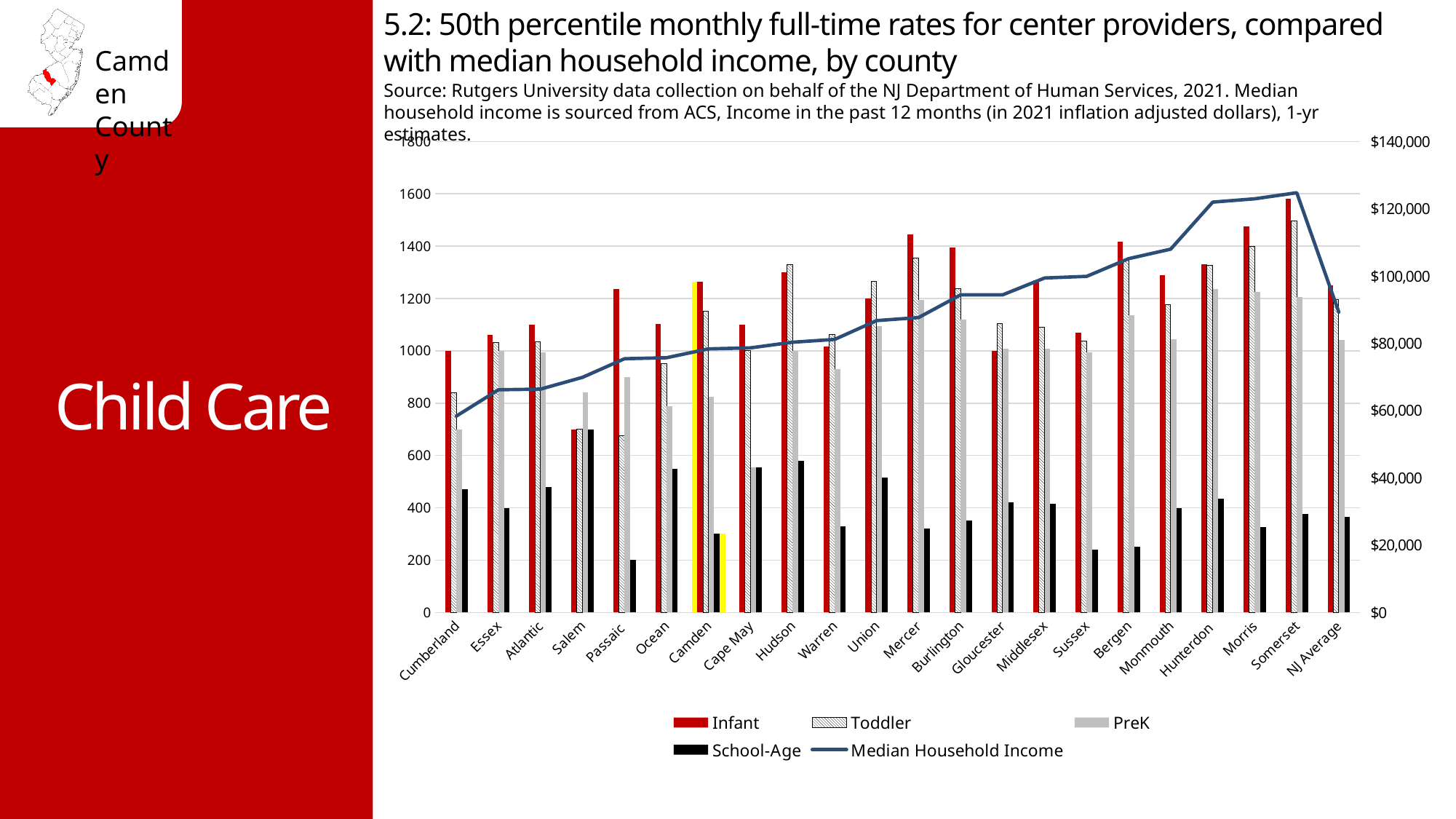
Which county has the highest Median Household Income? Somerset Is the Median Household Income for Hunterdon greater or less than $100,000? greater How many counties/categories are shown along the x axis? 22 Which county's bars are highlighted in yellow? Camden Is the School-Age rate for Camden greater or less than 400? less Which county has the lowest Infant rate? Salem What kind of chart is this? Bar chart with a line series Which county has the lowest School-Age rate? Passaic Is the Infant rate for Camden greater or less than 1200? greater Which county has the highest School-Age rate? Salem Which county has the highest Infant rate? Somerset How many series does the legend list? 5